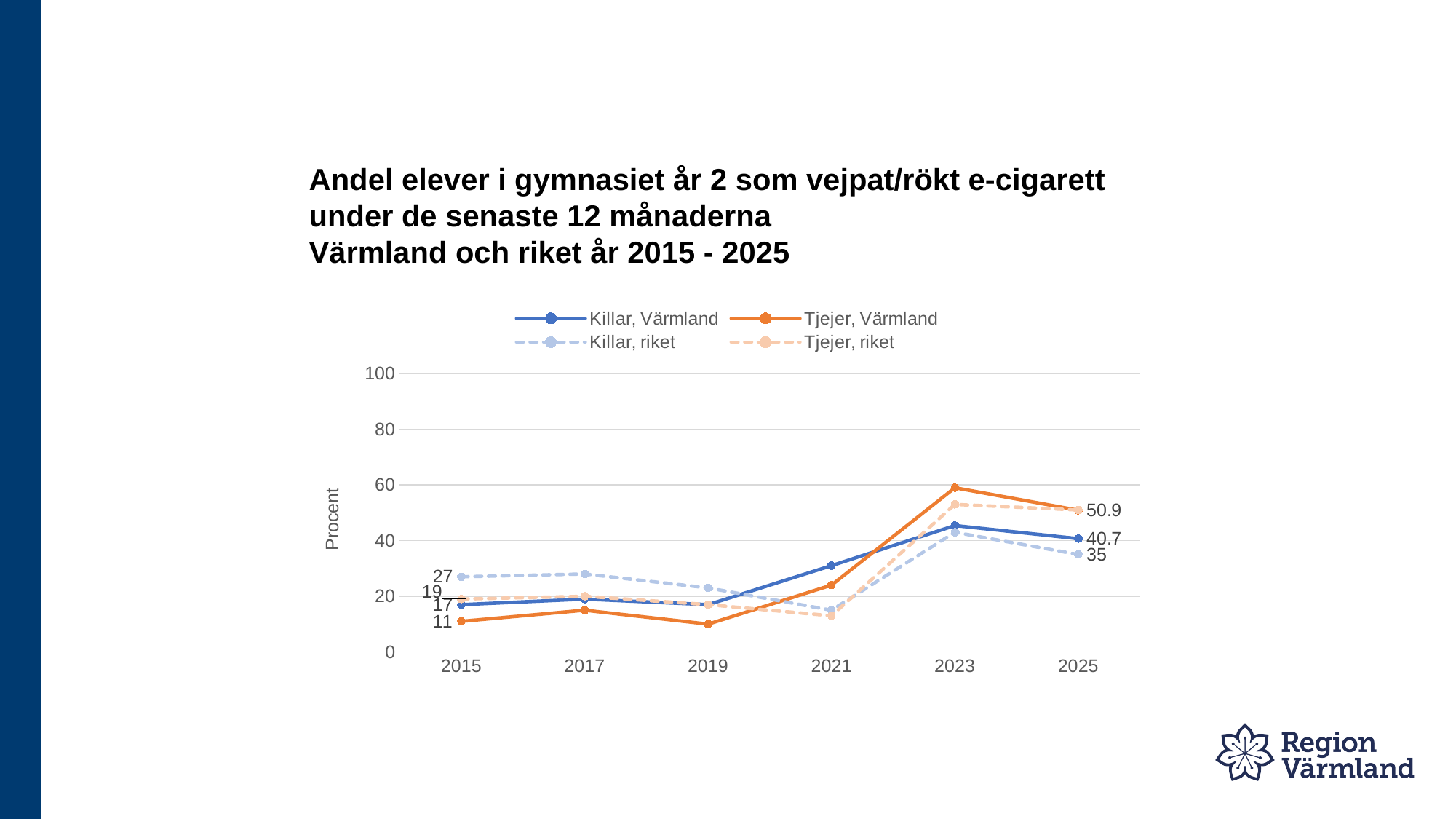
How many series does the legend list? 4 Is the value for Tjejer, Värmland in 2023 greater or less than 40? greater What is the difference between Killar, riket and Killar, Värmland in 2015? 10 How many years are shown on the x axis? 6 What is the label on the y axis? Procent What is the value for Tjejer, Värmland in 2015? 11 What kind of chart is shown on the slide? Line chart What is the value for Killar, riket in 2015? 27 What is the value for Killar, Värmland in 2015? 17 What is the value for Killar, riket in 2025? 35 What is the value for Killar, Värmland in 2025? 40.7 Which series has the highest value in 2015? Killar, riket